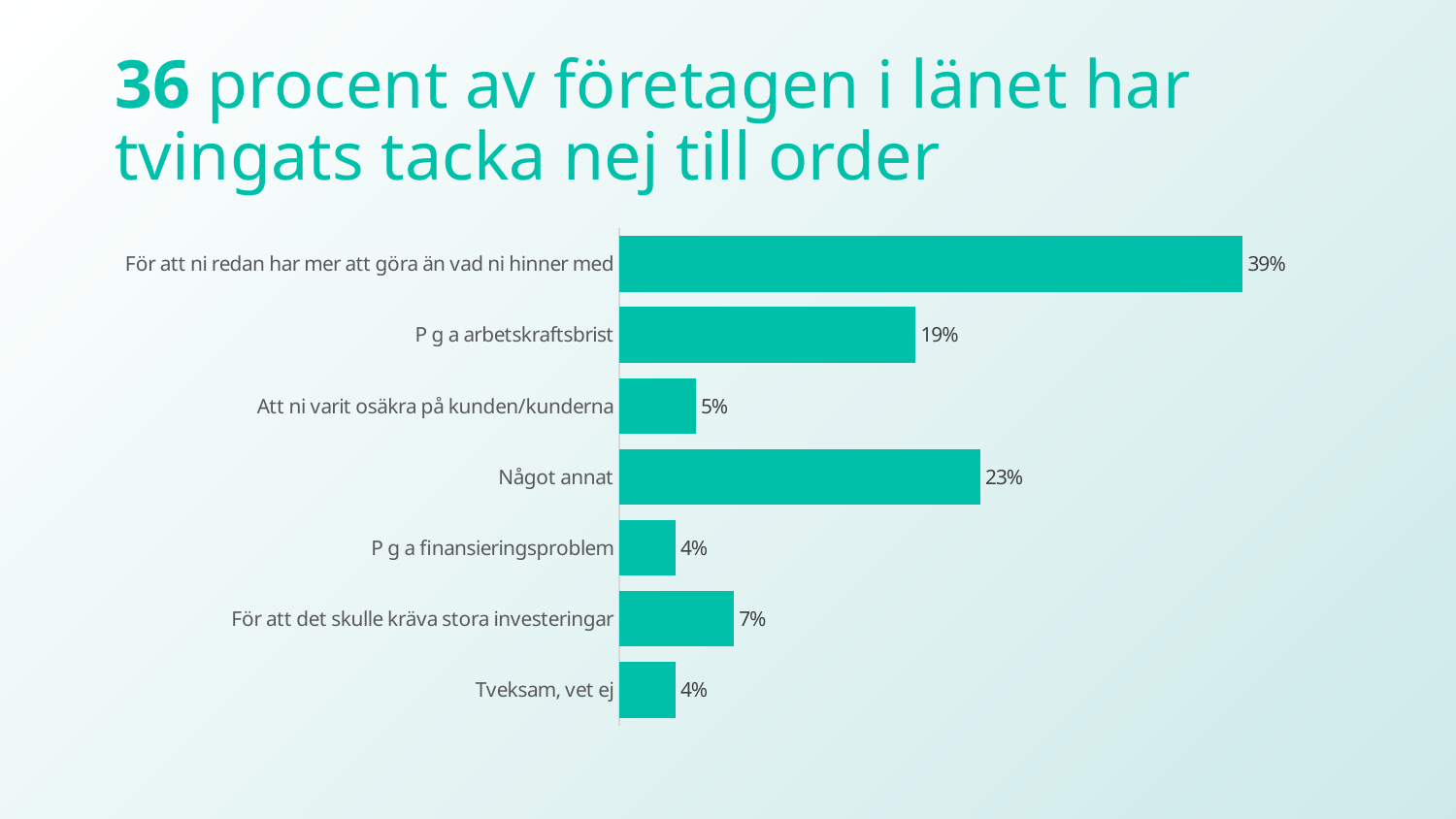
What kind of chart is shown on the slide? Bar chart What is the value for "För att det skulle kräva stora investeringar"? 7% What is the difference between "För att ni redan har mer att göra än vad ni hinner med" and "Något annat"? 16% Which category has the highest value? För att ni redan har mer att göra än vad ni hinner med What is the difference between "P g a arbetskraftsbrist" and "Att ni varit osäkra på kunden/kunderna"? 14% How many categories are shown in the chart? 7 What is the title of the slide? 36 procent av företagen i länet har tvingats tacka nej till order What is the value for "Att ni varit osäkra på kunden/kunderna"? 5% Which is larger, "För att det skulle kräva stora investeringar" or "P g a finansieringsproblem"? För att det skulle kräva stora investeringar What is the value for "Något annat"? 23% What is the value for "P g a arbetskraftsbrist"? 19% Which is larger, "Något annat" or "P g a arbetskraftsbrist"? Något annat